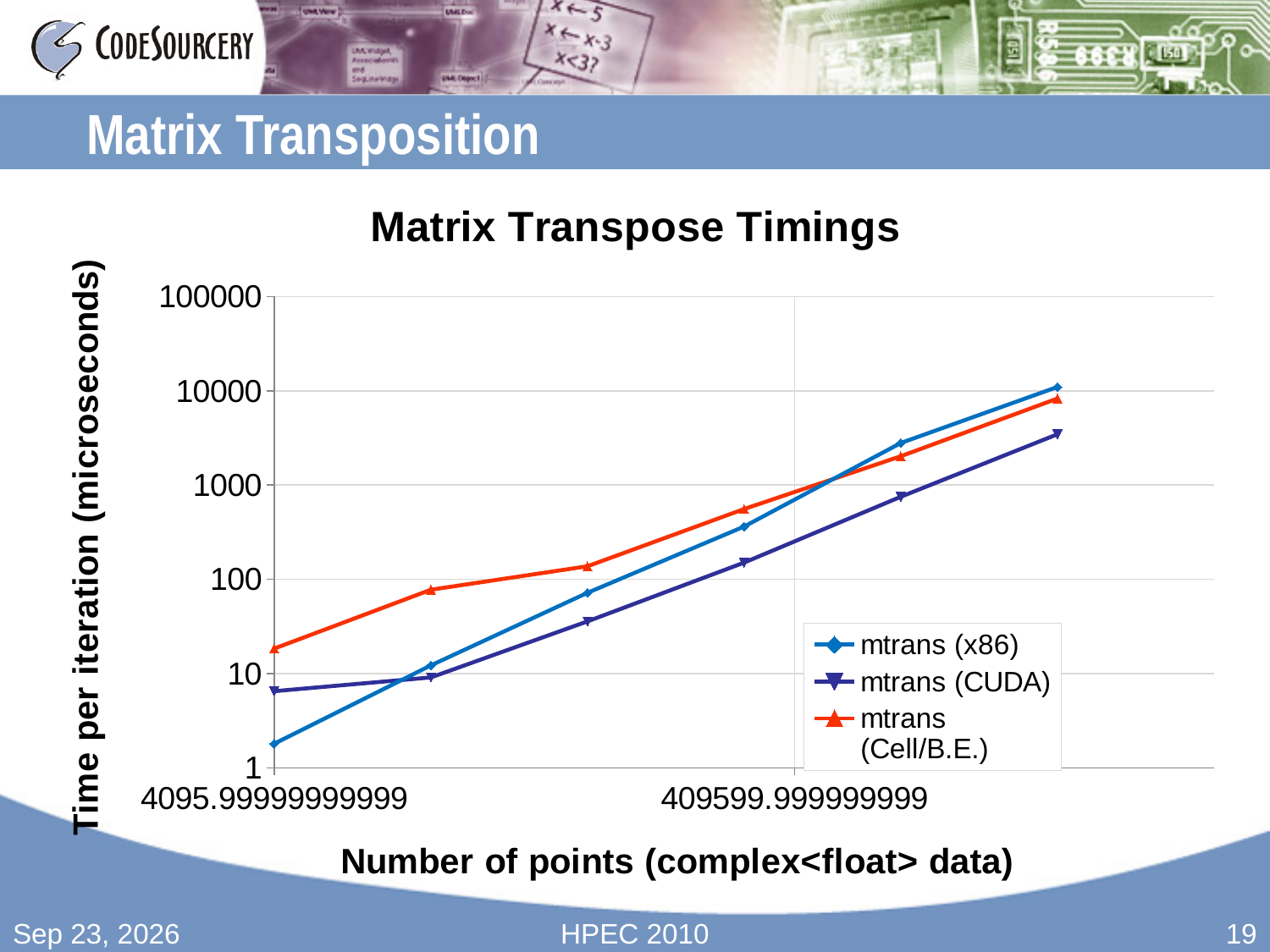
Is the value for mtrans (x86) at 4095.99999999999 points greater or less than 10? less Do the values for mtrans (CUDA) rise or fall as the number of points increases? rise How many series does the legend list? 3 Which series has the highest value at 4095.99999999999 points? mtrans (Cell/B.E.) Is the value for mtrans (CUDA) at the rightmost data point greater or less than 10000? less Which series has the lowest value at the rightmost data point? mtrans (CUDA) How many data points are plotted for the mtrans (x86) series? 6 What kind of chart is shown on the slide? line chart What is the label of the y axis? Time per iteration (microseconds) Is the value for mtrans (Cell/B.E.) at 4095.99999999999 points greater or less than 10? greater What is the title of the chart? Matrix Transpose Timings